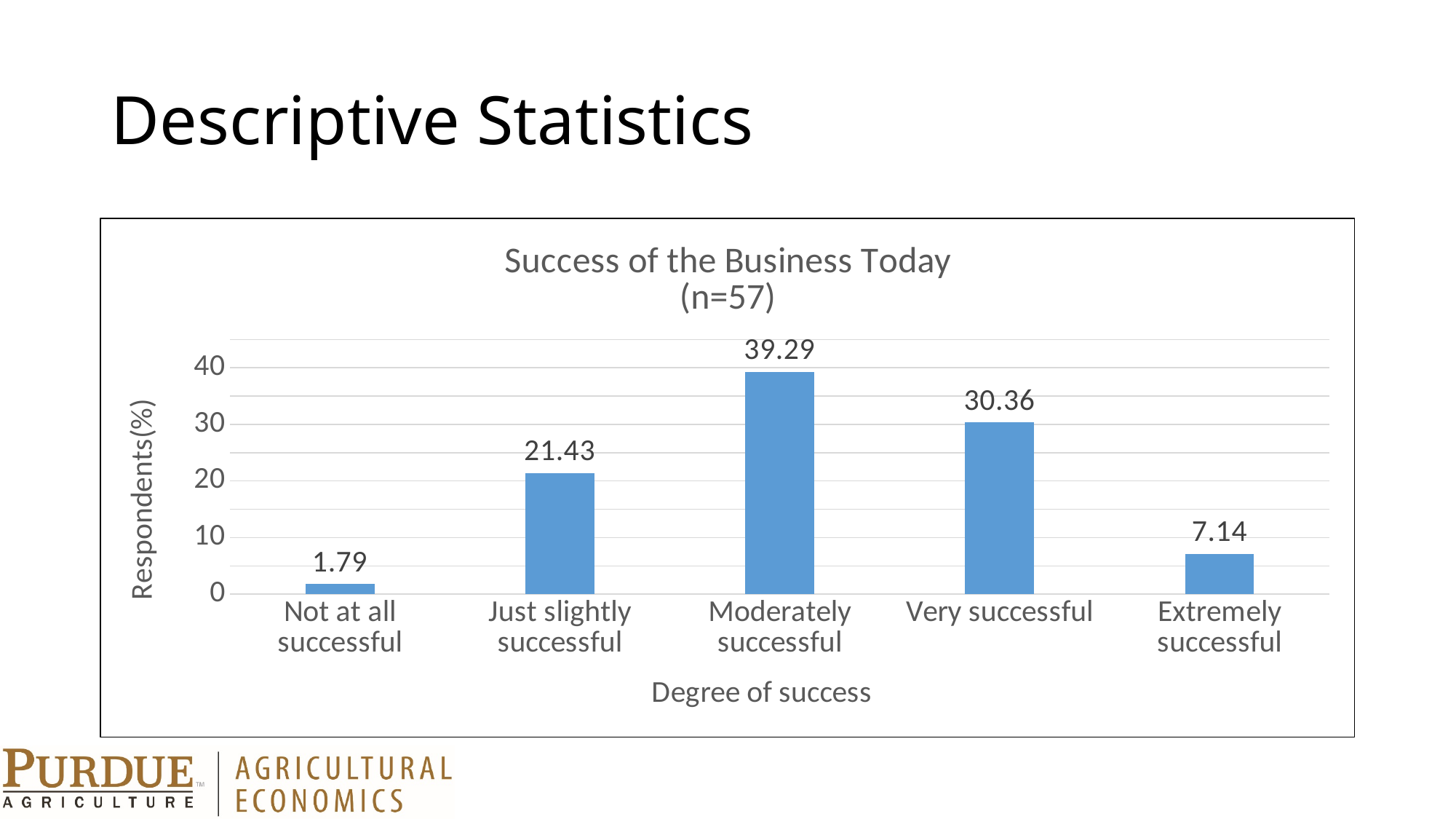
What is the title of the chart? Success of the Business Today (n=57) Which is larger, the value for Just slightly successful or the value for Extremely successful? Just slightly successful What is the label of the y axis? Respondents(%) What is the value for Moderately successful? 39.29 What is the value for Not at all successful? 1.79 How many categories are shown on the x axis? 5 Which degree of success has the lowest percentage of respondents? Not at all successful What is the difference between the values for Moderately successful and Very successful? 8.93 What kind of chart is shown on the slide? Bar chart Is the value for Very successful greater or less than 30? greater What is the value for Extremely successful? 7.14 Which degree of success has the highest percentage of respondents? Moderately successful